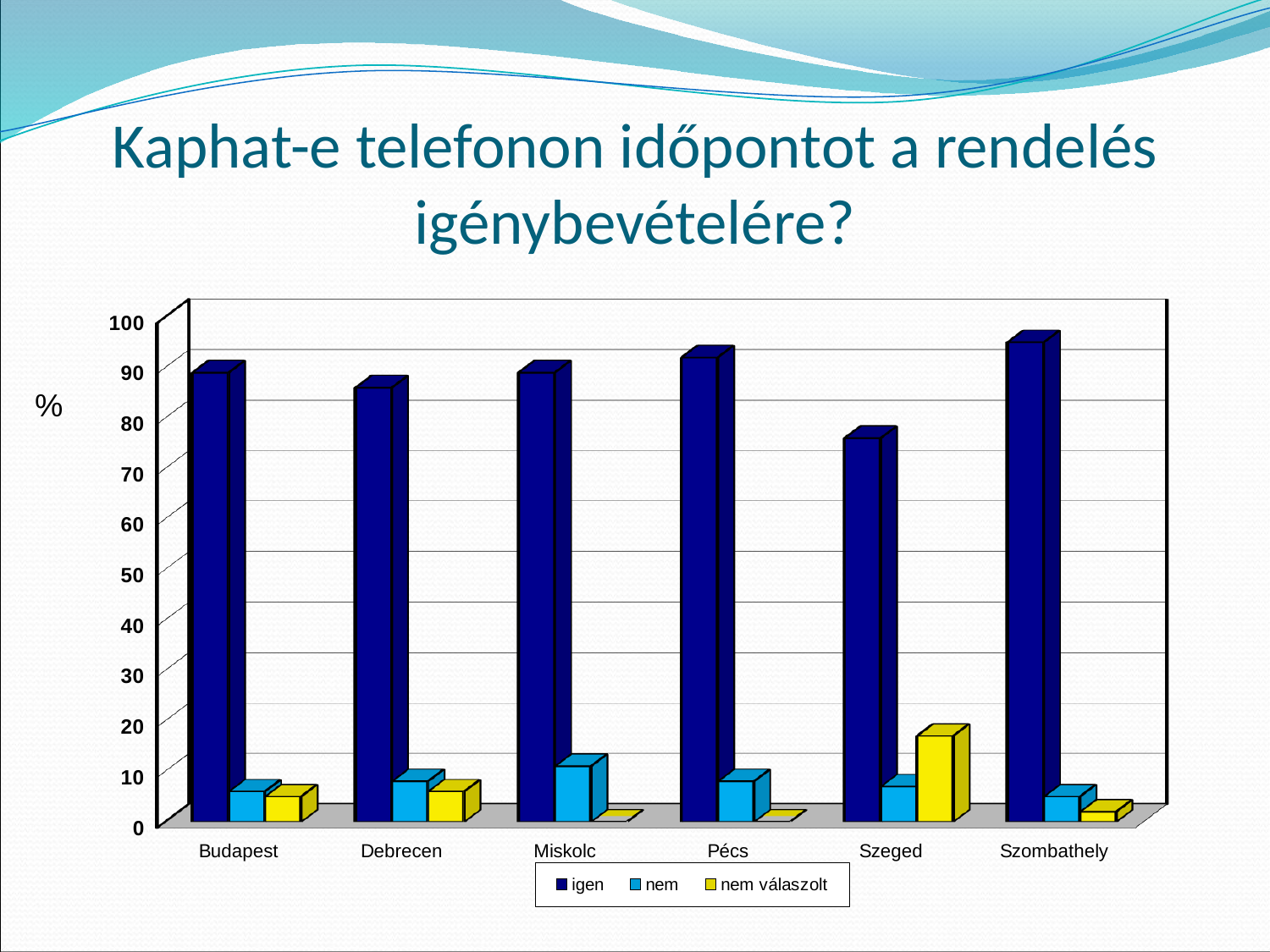
Is the 'igen' value for Szeged greater or less than 80? less Which series is shown in yellow in the chart's legend? nem válaszolt Which city has the highest value for the 'igen' series? Szombathely Is the 'igen' value for Szombathely greater or less than 90? greater Which city has the highest value for the 'nem válaszolt' series? Szeged Is the 'nem válaszolt' value for Szeged greater or less than 10? greater What is the title of the chart on the slide? Kaphat-e telefonon időpontot a rendelés igénybevételére? Which is larger for Pécs: the 'igen' value or the 'nem' value? igen What kind of chart is shown on the slide? bar chart Which city has the lowest value for the 'igen' series? Szeged How many cities are shown on the x axis of the chart? 6 How many series does the chart's legend list? 3